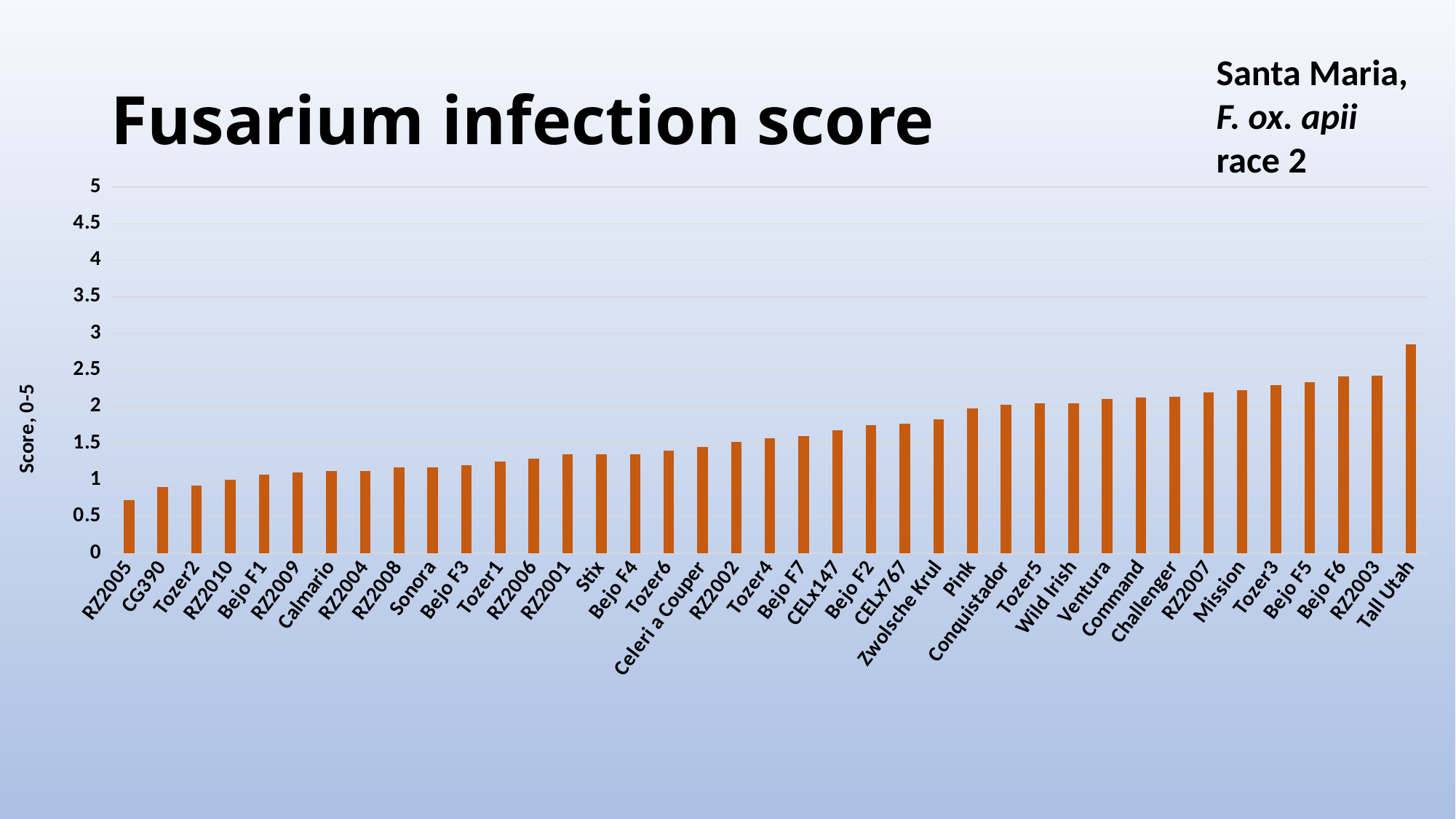
What is the label of the vertical axis? Score, 0-5 Which variety has the lowest Fusarium infection score? RZ2005 Is the value for Tall Utah greater or less than 2.5? greater What kind of chart is shown on the slide? bar chart How many varieties are plotted on the chart? 39 Which variety has the highest Fusarium infection score? Tall Utah Is the value for Mission greater or less than 2? greater Which has a higher Fusarium infection score, Bejo F6 or Bejo F1? Bejo F6 Is the value for RZ2005 greater or less than 1? less Do the values rise or fall from left to right along the x axis? rise What is the title of the chart? Fusarium infection score